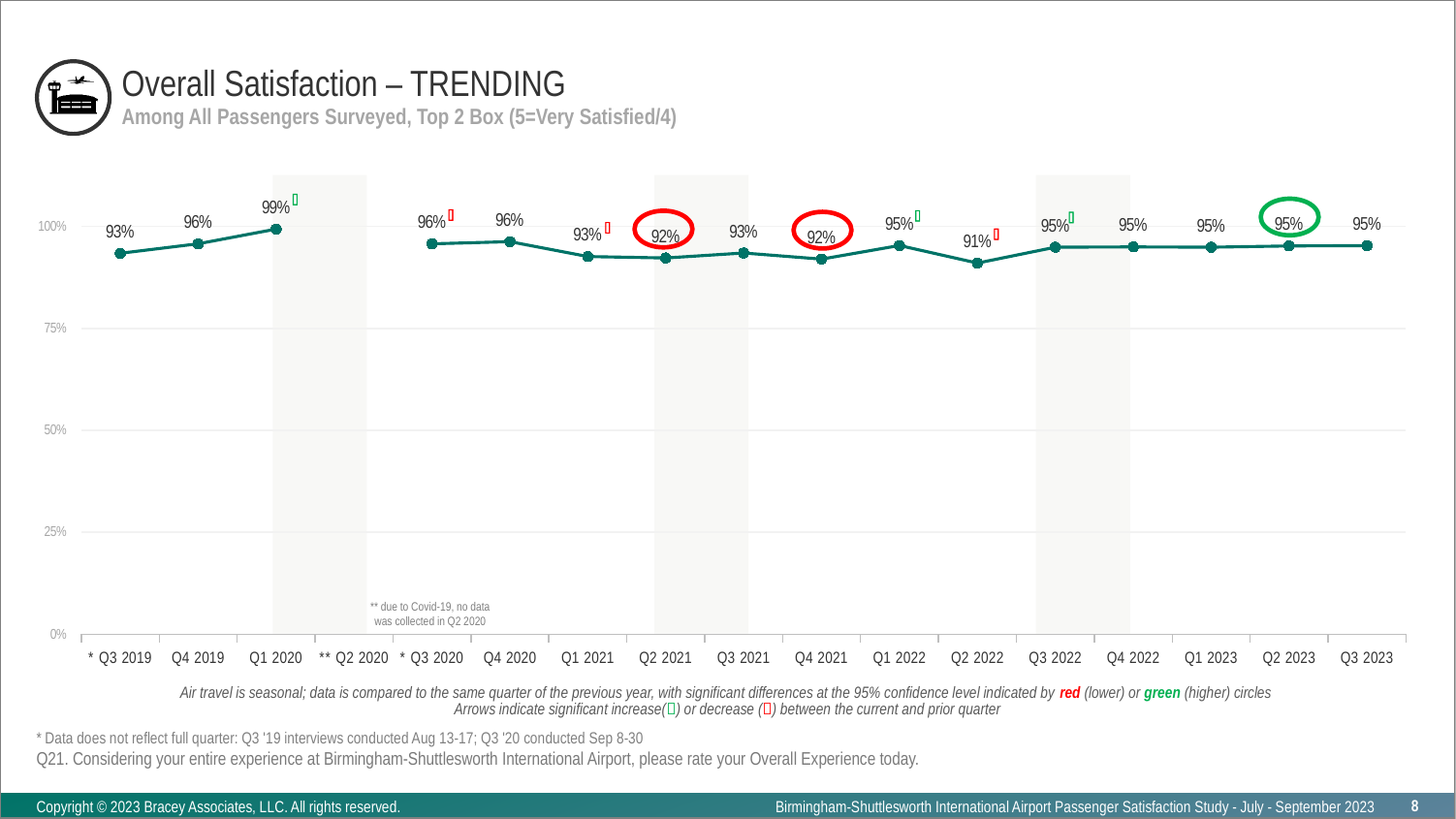
What is the overall satisfaction value for Q2 2022? 91% What is the overall satisfaction value for Q1 2020? 99% What is the overall satisfaction value for Q3 2019? 93% Which quarter has the lowest overall satisfaction value? Q2 2022 What is the difference between the Q1 2020 value and the Q2 2022 value? 8% Which is larger, the value for Q4 2019 or the value for Q2 2021? Q4 2019 Which quarter has no data plotted on the chart? Q2 2020 What kind of chart is shown on the slide? line chart Which quarter has the highest overall satisfaction value? Q1 2020 How many quarters are labelled on the x axis? 17 Is the value for Q4 2021 greater or less than 75%? greater What is the overall satisfaction value for Q3 2023? 95%